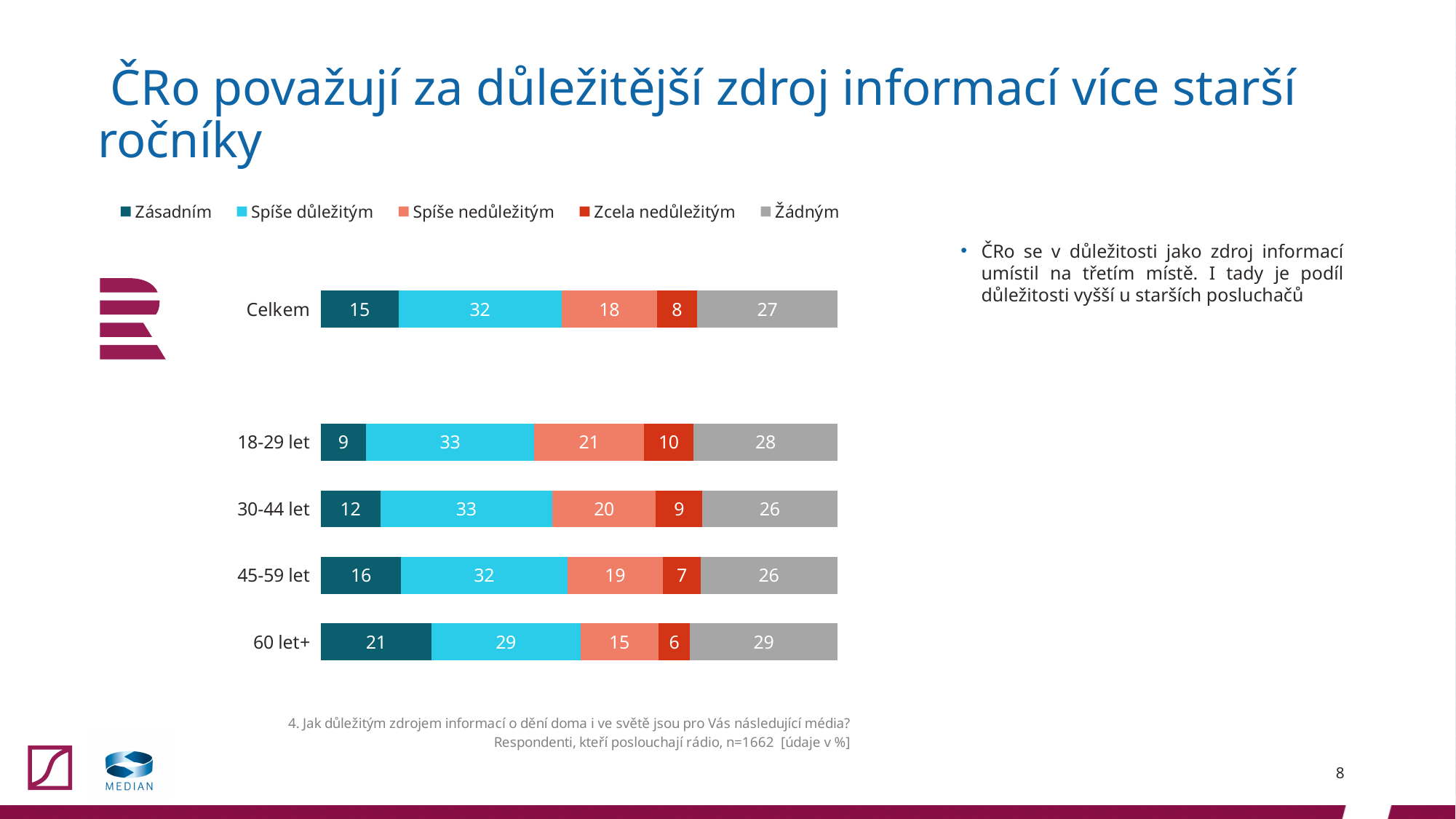
Going from the 18-29 let group to the 60 let+ group, does the Zásadním value rise or fall? Rise Which age group has the highest Zásadním value? 60 let+ What is the difference between the Zásadním value for 60 let+ and for 18-29 let? 12 How many categories (bars) are shown in the chart? 5 Which has the larger Spíše důležitým value: 45-59 let or 60 let+? 45-59 let What kind of chart is shown on the slide? Stacked bar chart How many series does the legend list? 5 What is the value of the Zásadním segment for the 60 let+ group? 21 Which age group has the lowest Zásadním value? 18-29 let What is the total of the stacked bar for Celkem? 100 What is the value of the Zcela nedůležitým segment for the 30-44 let group? 9 What is the value of the Žádným segment for the 18-29 let group? 28